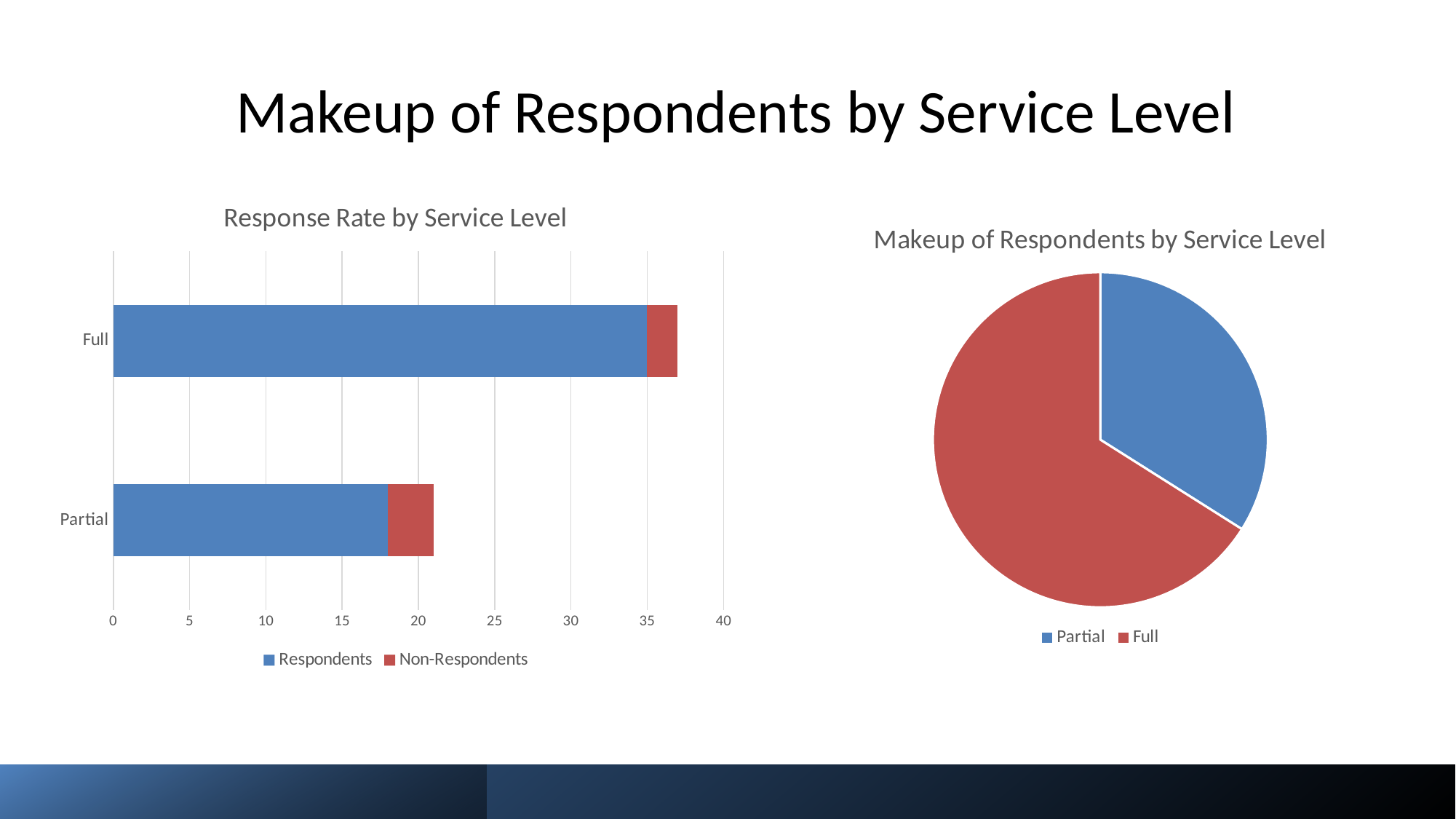
In the 'Response Rate by Service Level' chart, which service level has the longer total bar? Full What kind of chart is the 'Response Rate by Service Level' chart on the left? bar chart What kind of chart is the 'Makeup of Respondents by Service Level' chart on the right? pie chart In the 'Response Rate by Service Level' chart, is the total bar length for Full greater or less than 35? greater In the 'Response Rate by Service Level' chart, is the Respondents value for Partial greater or less than 20? less In the 'Makeup of Respondents by Service Level' pie chart, which slice is larger, Partial or Full? Full In the 'Makeup of Respondents by Service Level' pie chart, what colour is the Full slice? red In the 'Response Rate by Service Level' chart, how many series does the legend list? 2 In the 'Response Rate by Service Level' chart, is the Respondents value for Full greater or less than 30? greater In the 'Response Rate by Service Level' chart, how many service level categories are shown? 2 In the 'Makeup of Respondents by Service Level' pie chart, how many slices are there? 2 In the 'Response Rate by Service Level' chart, which has more Respondents, Full or Partial? Full